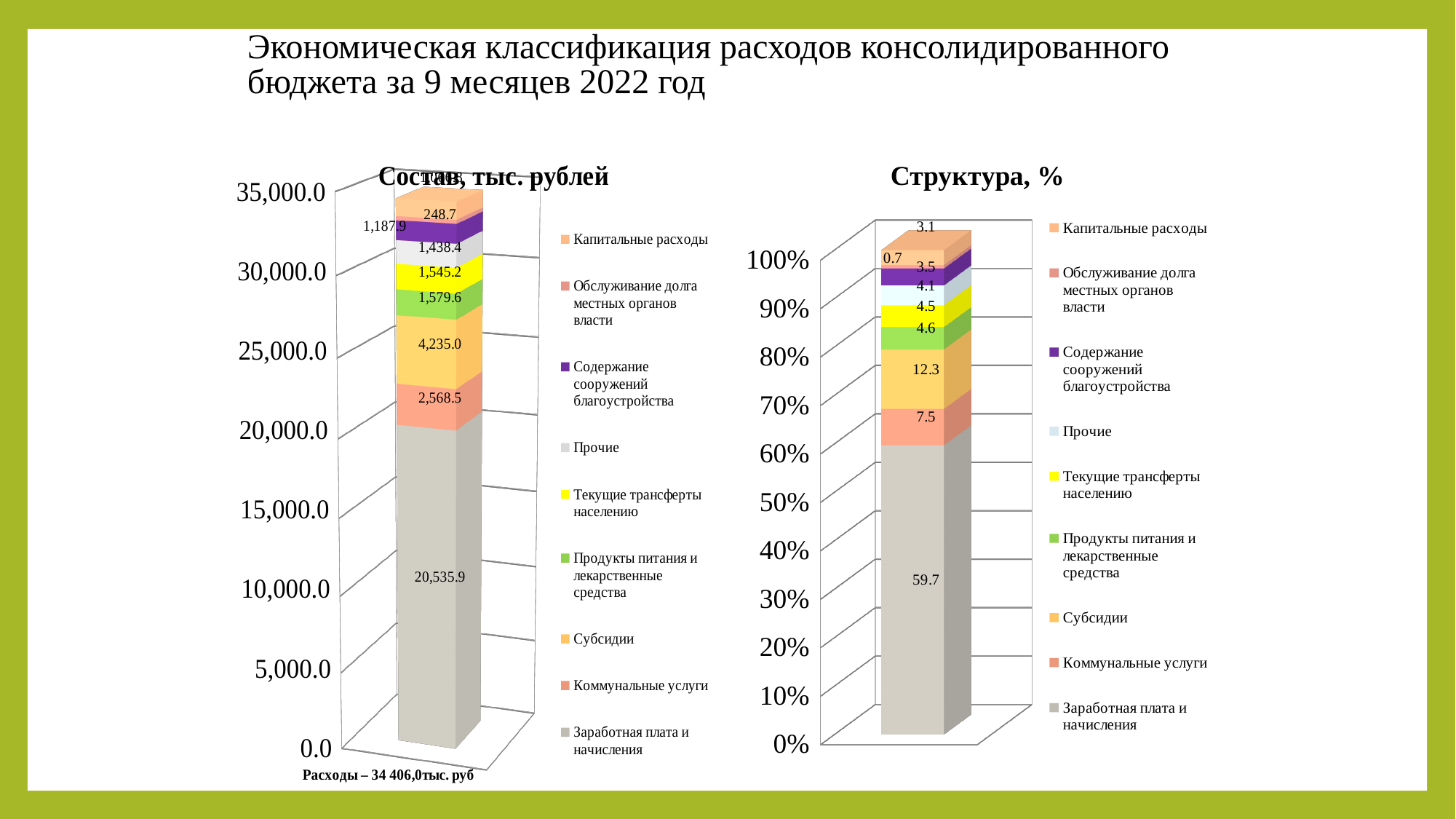
What is the title of the chart on the right side of the slide? Структура, % In the chart 'Состав, тыс. рублей', which is larger: Продукты питания и лекарственные средства or Текущие трансферты населению? Продукты питания и лекарственные средства In the chart 'Структура, %', which category has the smallest share? Обслуживание долга местных органов власти In the chart 'Состав, тыс. рублей', what is the value for Заработная плата и начисления? 20,535.9 How many series does the legend of the chart 'Структура, %' list? 9 In the chart 'Структура, %', what is the value for Капитальные расходы? 3.1 In the chart 'Структура, %', what is the difference between Субсидии and Продукты питания и лекарственные средства? 7.7 In the chart 'Состав, тыс. рублей', which category has the largest value? Заработная плата и начисления In the chart 'Состав, тыс. рублей', what is the value for Субсидии? 4,235.0 In the chart 'Состав, тыс. рублей', what is the difference between Субсидии and Коммунальные услуги? 1,666.5 What kind of chart is 'Состав, тыс. рублей'? Stacked bar chart In the chart 'Структура, %', what is the value for Коммунальные услуги? 7.5